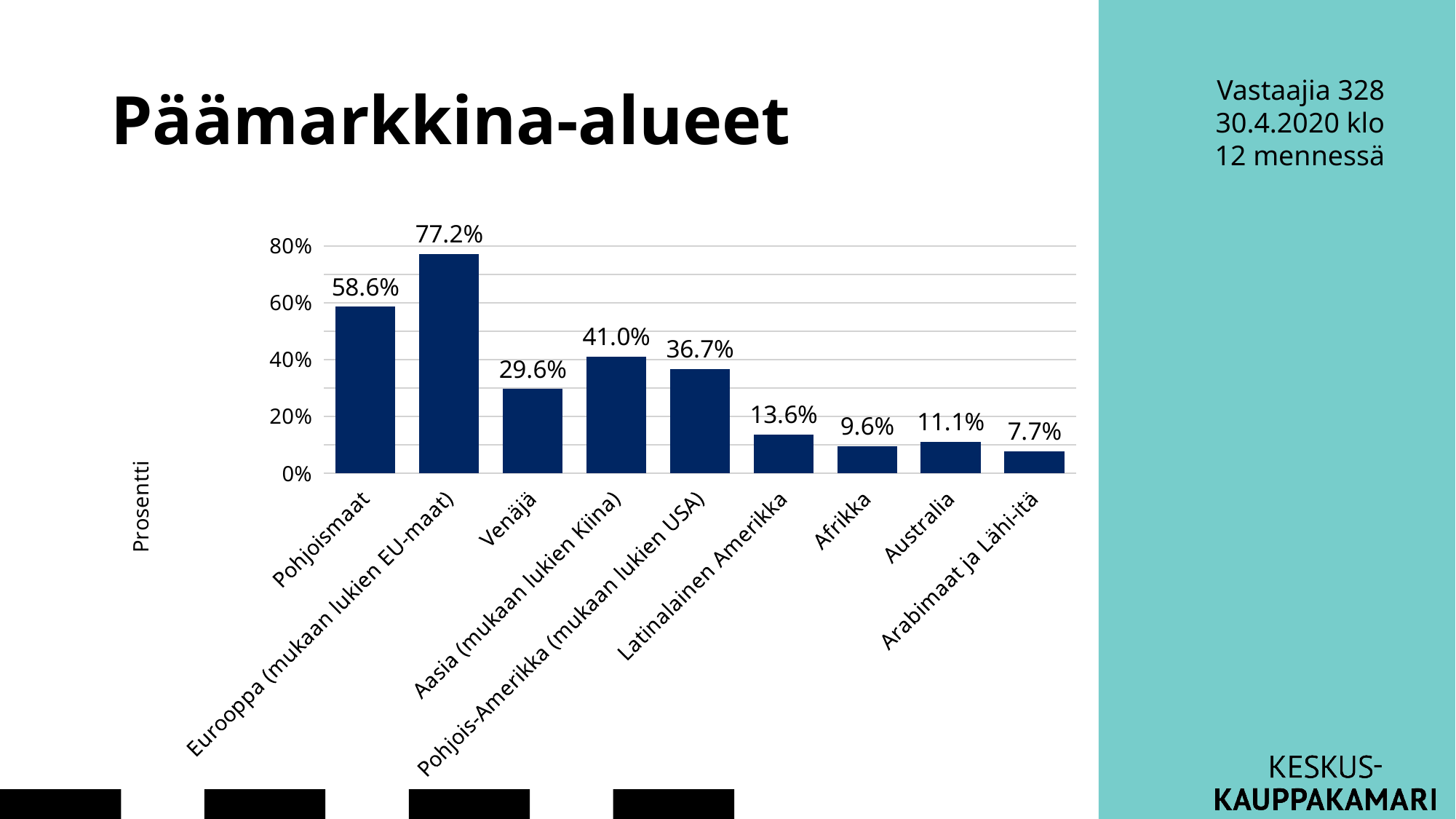
How many categories are shown on the x axis? 9 What is the value for Eurooppa (mukaan lukien EU-maat)? 77.2% What is the value for Pohjoismaat? 58.6% Which category has the lowest value? Arabimaat ja Lähi-itä What is the value for Venäjä? 29.6% Which is larger, the value for Afrikka or the value for Australia? Australia What is the label of the y axis? Prosentti What is the title of the slide? Päämarkkina-alueet What is the value for Latinalainen Amerikka? 13.6% What kind of chart is shown on the slide? Bar chart What is the difference between the values for Aasia (mukaan lukien Kiina) and Pohjois-Amerikka (mukaan lukien USA)? 4.3% Which category has the highest value? Eurooppa (mukaan lukien EU-maat)